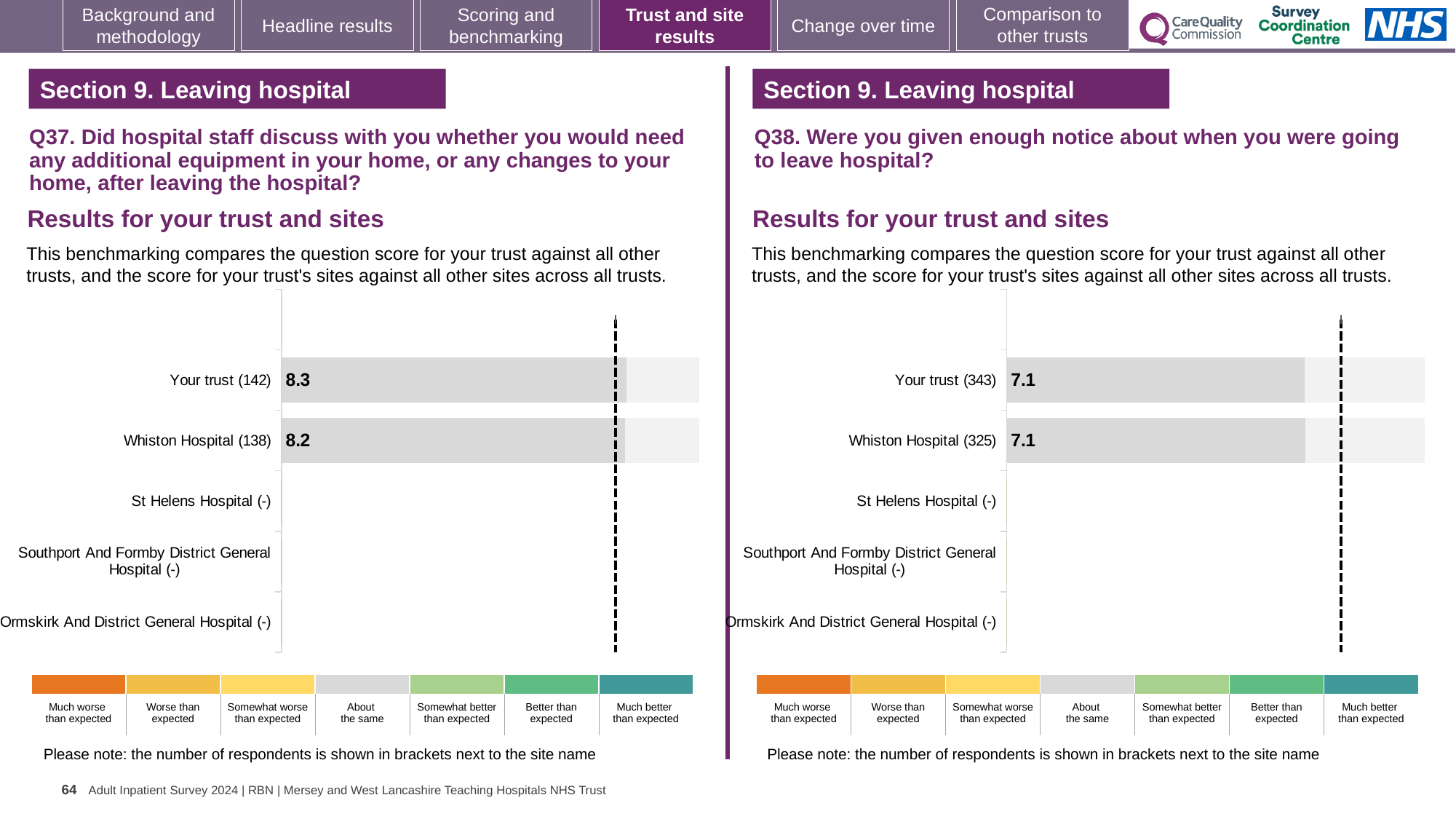
In the Q38 chart on the right, what is the score for Whiston Hospital? 7.1 In the Q37 chart on the left, what is the score for Whiston Hospital? 8.2 In the Q38 chart on the right, how many respondents are shown in brackets for Whiston Hospital? 325 In the Q38 chart on the right, how many categories have a plotted bar with a score? 2 In the Q37 chart on the left, how many respondents are shown in brackets for Your trust? 142 How many benchmark bands are shown in the colour key below the Q37 chart on the left? 7 In the Q37 chart on the left, what is the score for Your trust? 8.3 In the Q38 chart on the right, what is the score for Your trust? 7.1 In the Q37 chart on the left, what is the difference between the score for Your trust and the score for Whiston Hospital? 0.1 In the Q37 chart on the left, how many site or trust categories are listed on the vertical axis? 5 What kind of chart is used in the Q38 chart on the right? Bar chart In the Q37 chart on the left, which category has the highest score? Your trust (142)